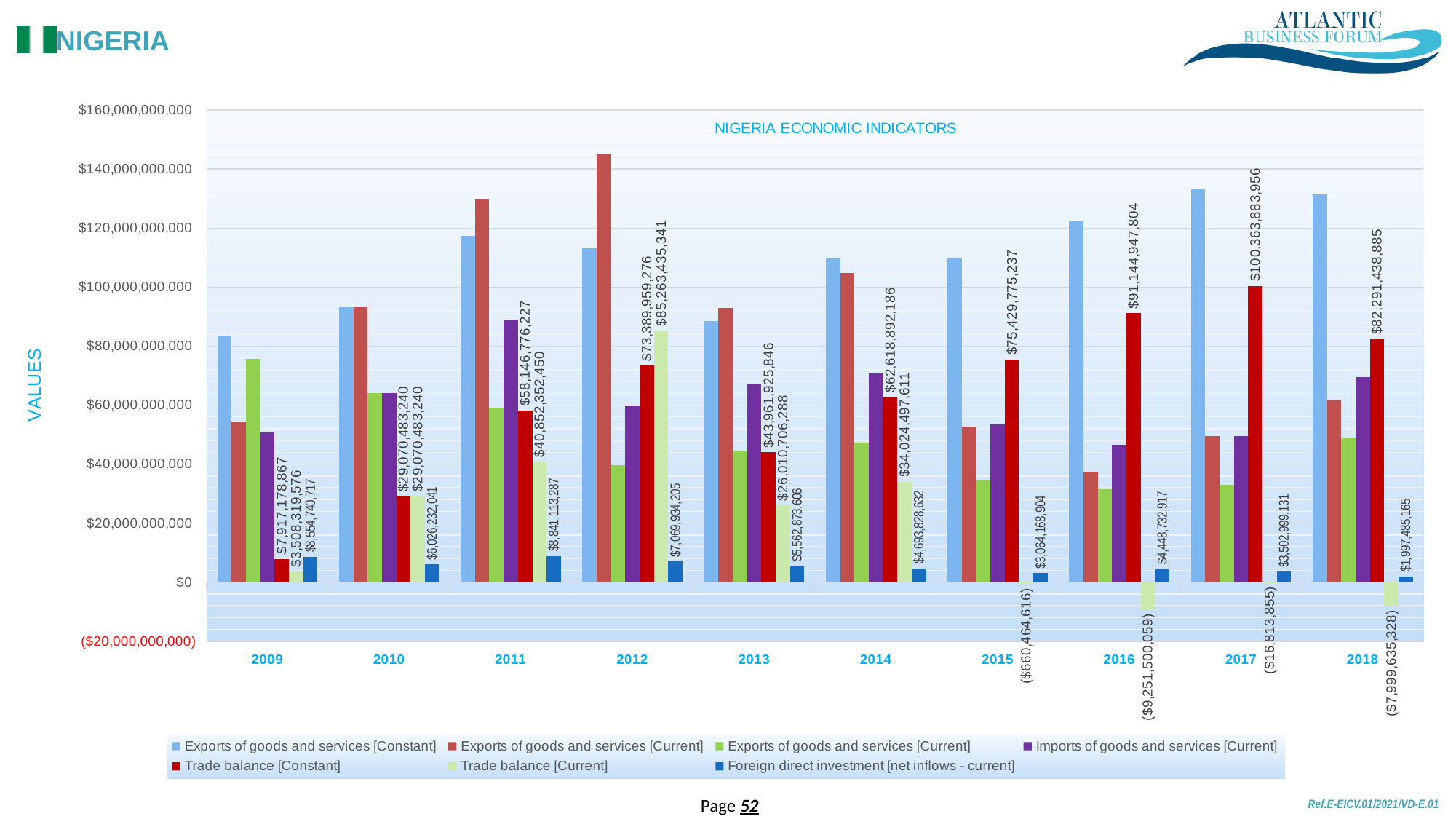
In which year is Trade balance [Constant] the highest? 2017 What is the value of Trade balance [Constant] for 2017? $100,363,883,956 Which year has the larger Trade balance [Constant], 2016 or 2018? 2016 What is the difference between Foreign direct investment [net inflows - current] in 2009 and in 2018? $6,557,255,552 In which year is Foreign direct investment [net inflows - current] the lowest? 2018 What is the value of Foreign direct investment [net inflows - current] for 2018? $1,997,485,165 What is the value of Trade balance [Current] for 2016? ($9,251,500,059) How many years are shown on the x axis of the chart? 10 How many series does the chart legend list? 7 What is the title of the chart? NIGERIA ECONOMIC INDICATORS Is the value for Exports of goods and services [Constant] in 2017 greater or less than $120,000,000,000? greater What type of chart is shown on the slide? bar chart